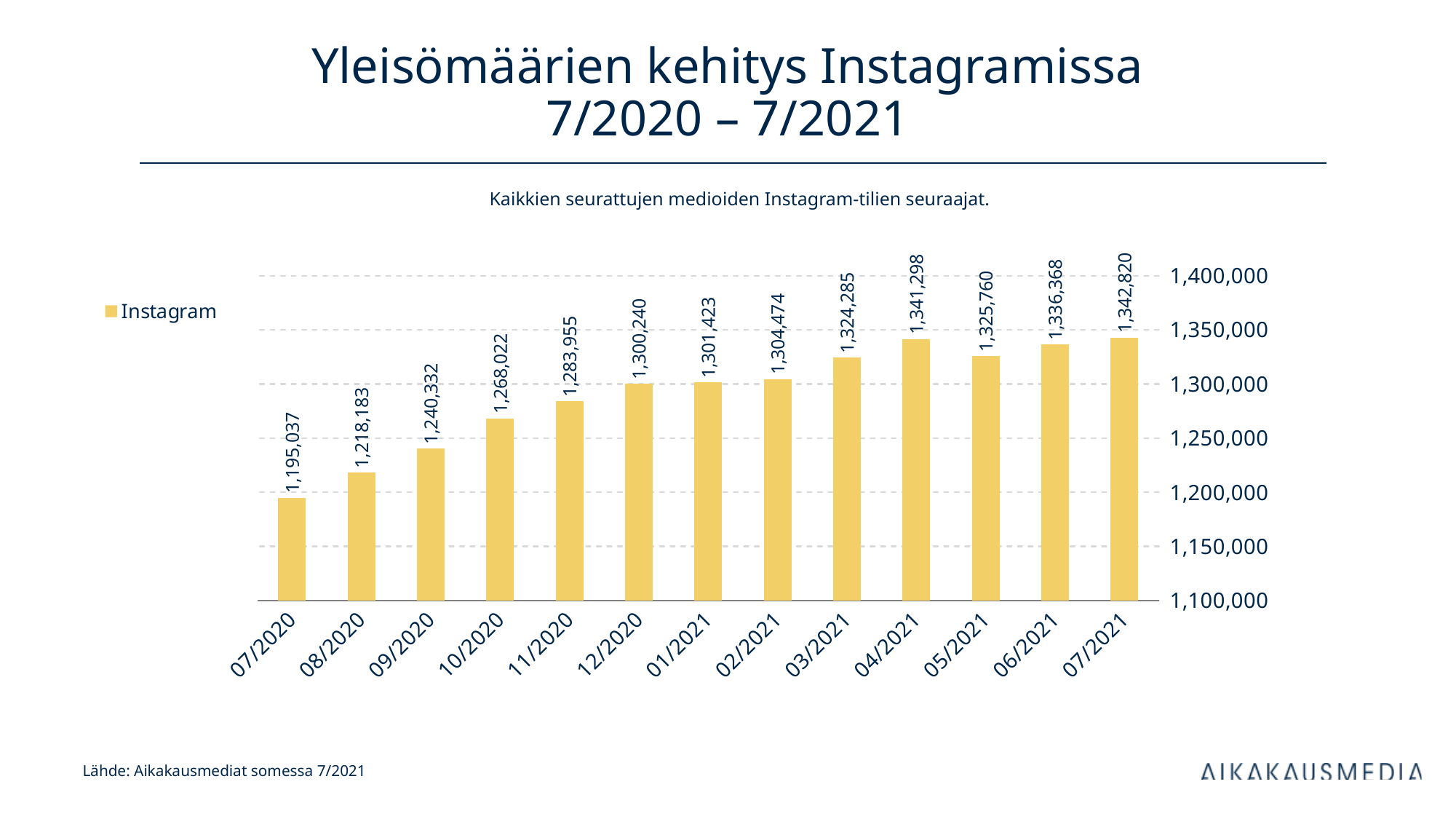
How many series does the legend list? 1 What is the difference between the values for 07/2021 and 07/2020? 147,783 What is the value for 12/2020? 1,300,240 Which month has the highest value? 07/2021 Which month has the lowest value? 07/2020 What kind of chart is shown on the slide? bar chart What is the value for 04/2021? 1,341,298 What is the difference between the values for 04/2021 and 05/2021? 15,538 Which is larger, the value for 04/2021 or the value for 05/2021? 04/2021 Is the value for 09/2020 greater or less than 1,250,000? less What is the value for 07/2020? 1,195,037 How many months are shown on the x axis? 13